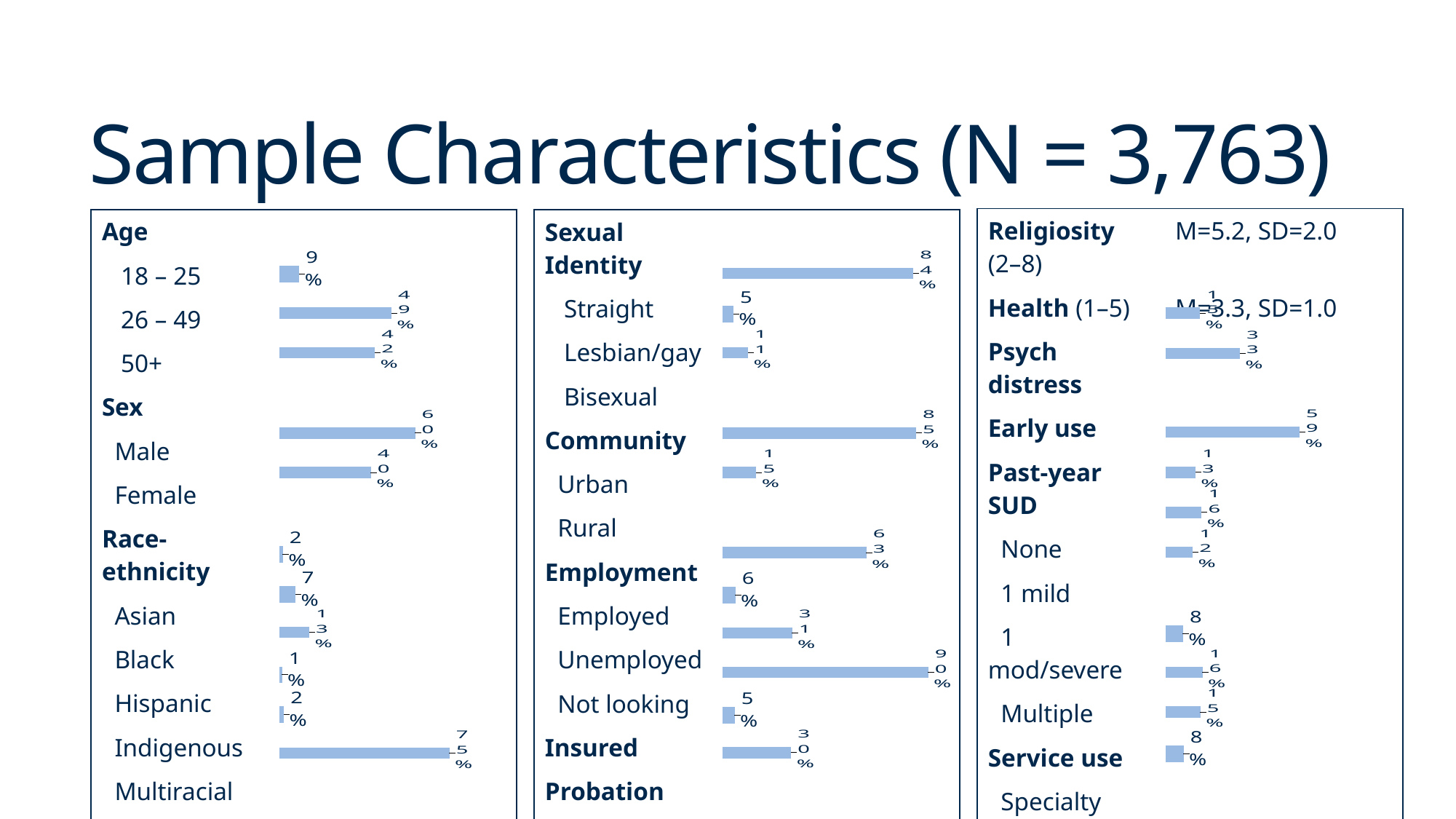
What type of chart is used to display the sample characteristics on this slide? Bar chart In the left panel, what is the difference between the Male and Female percentages? 20% In the middle panel, what percentage of the sample lives in an Urban community? 85% In the left panel, which age group has the largest share of the sample? 26 – 49 In the middle panel, which is larger: the Employed share or the Not looking share? Employed In the middle panel, what percentage of the sample identifies as Straight? 84% In the right panel, what is the mean Religiosity score shown? M=5.2 In the left panel, what percentage of the sample is Male? 60% In the right panel, what percentage of the sample reported Early use? 59% In the middle panel, what is the difference between the Urban and Rural percentages? 70% In the middle panel, what percentage of the sample is Insured? 90% In the left panel, what percentage of the sample is aged 26 – 49? 49%